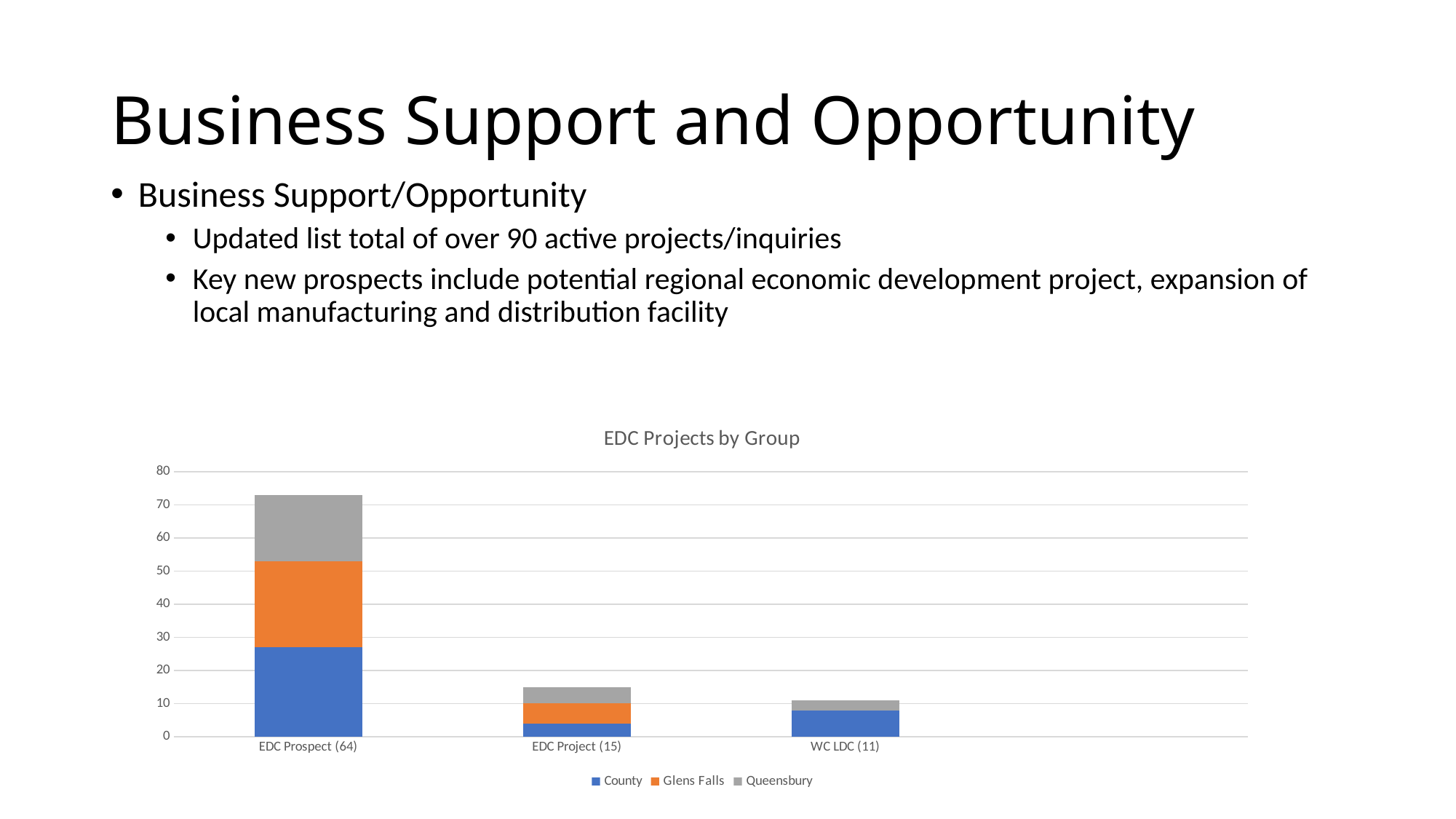
Which category has the tallest stacked bar in the chart? EDC Prospect (64) Is the total height of the WC LDC (11) bar greater or less than 20? less Is the total height of the EDC Prospect (64) bar greater or less than 70? greater Is the total height of the EDC Project (15) bar greater or less than 20? less How many series does the chart legend list? 3 Which category has the shortest stacked bar in the chart? WC LDC (11) How many categories are shown on the x axis of the chart? 3 Which series is shown in orange in the chart legend? Glens Falls What is the title of the chart? EDC Projects by Group Which stacked bar is taller, EDC Project (15) or WC LDC (11)? EDC Project (15) What kind of chart is shown on the slide? Stacked bar chart